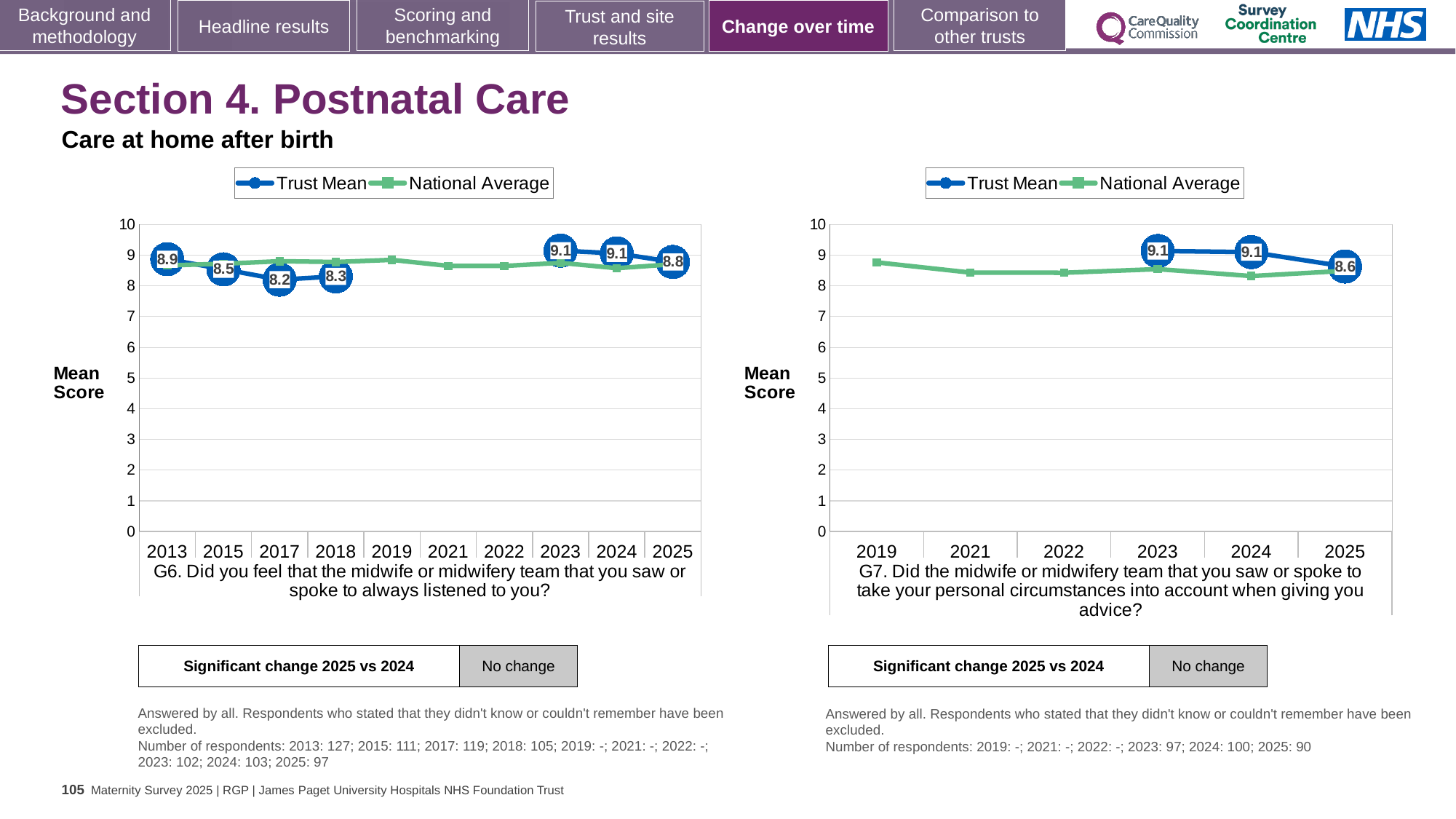
What type of chart is the left chart (G6)? line chart In the right chart (G7), does the Trust Mean rise or fall from 2024 to 2025? fall In the left chart (G6), which year has the lowest labelled Trust Mean value? 2017 In the left chart (G6), what is the Trust Mean value for 2025? 8.8 In the right chart (G7), what is the Trust Mean value for 2025? 8.6 In the left chart (G6), what is the difference between the Trust Mean values for 2023 and 2017? 0.9 In the left chart (G6), what is the Trust Mean value for 2013? 8.9 In the left chart (G6), is the Trust Mean value for 2015 larger or smaller than the value for 2018? larger How many series does the legend of the left chart (G6) list? 2 In the right chart (G7), what is the difference between the Trust Mean values for 2024 and 2025? 0.5 How many years are shown on the x axis of the right chart (G7)? 6 In the right chart (G7), is the National Average value for 2019 greater or less than 8? greater